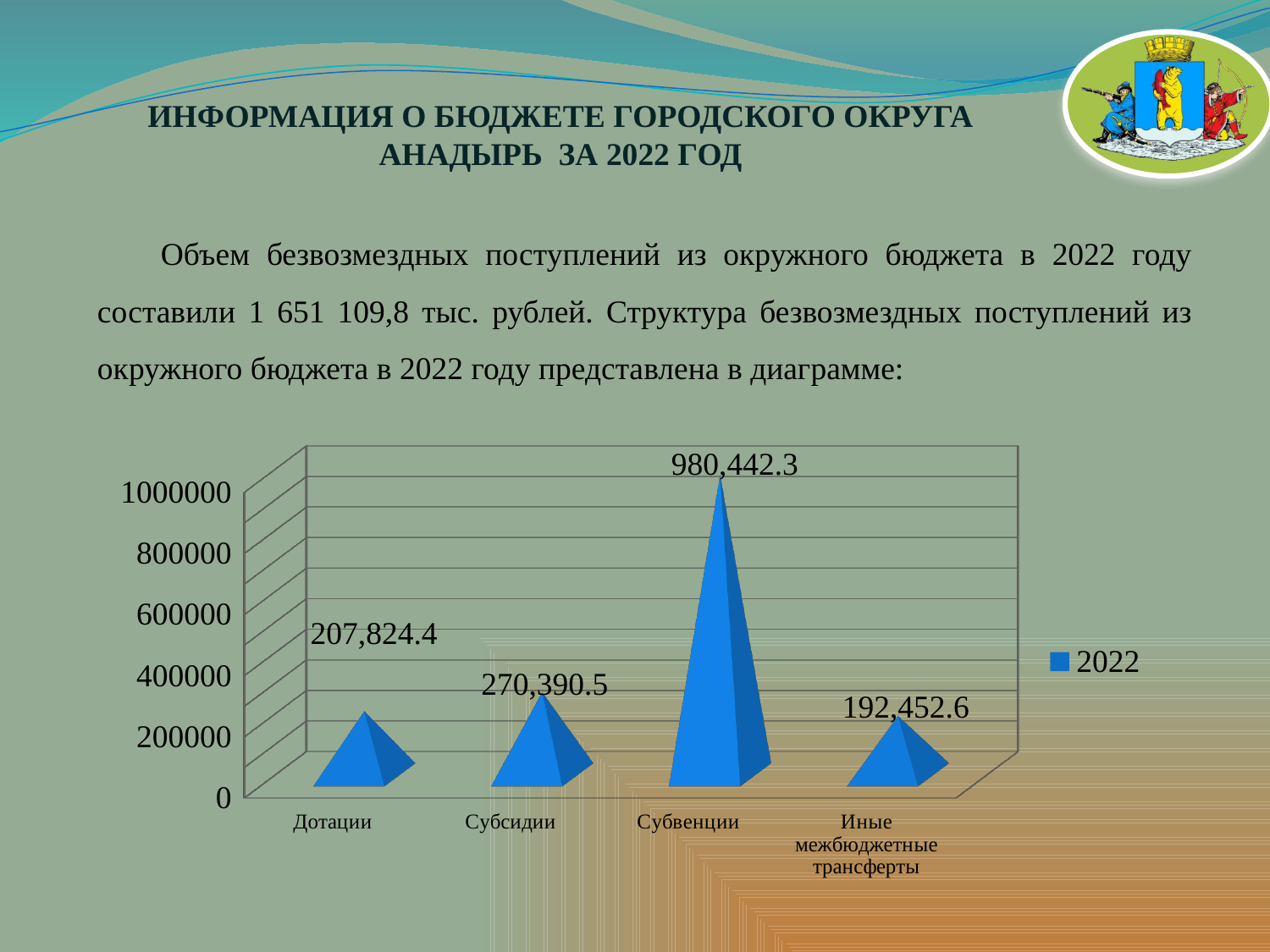
What is the value for Иные межбюджетные трансферты? 192,452.6 What is the difference between the values for Субвенции and Субсидии? 710,051.8 What is the value for Субсидии? 270,390.5 What is the difference between the values for Субсидии and Дотации? 62,566.1 Which category has the lowest value? Иные межбюджетные трансферты Which category has the highest value? Субвенции What series does the legend list? 2022 What is the value for Субвенции? 980,442.3 Which is larger, the value for Субсидии or the value for Дотации? Субсидии What is the value for Дотации? 207,824.4 How many categories are shown on the x axis? 4 Is the value for Субвенции greater or less than 800000? greater